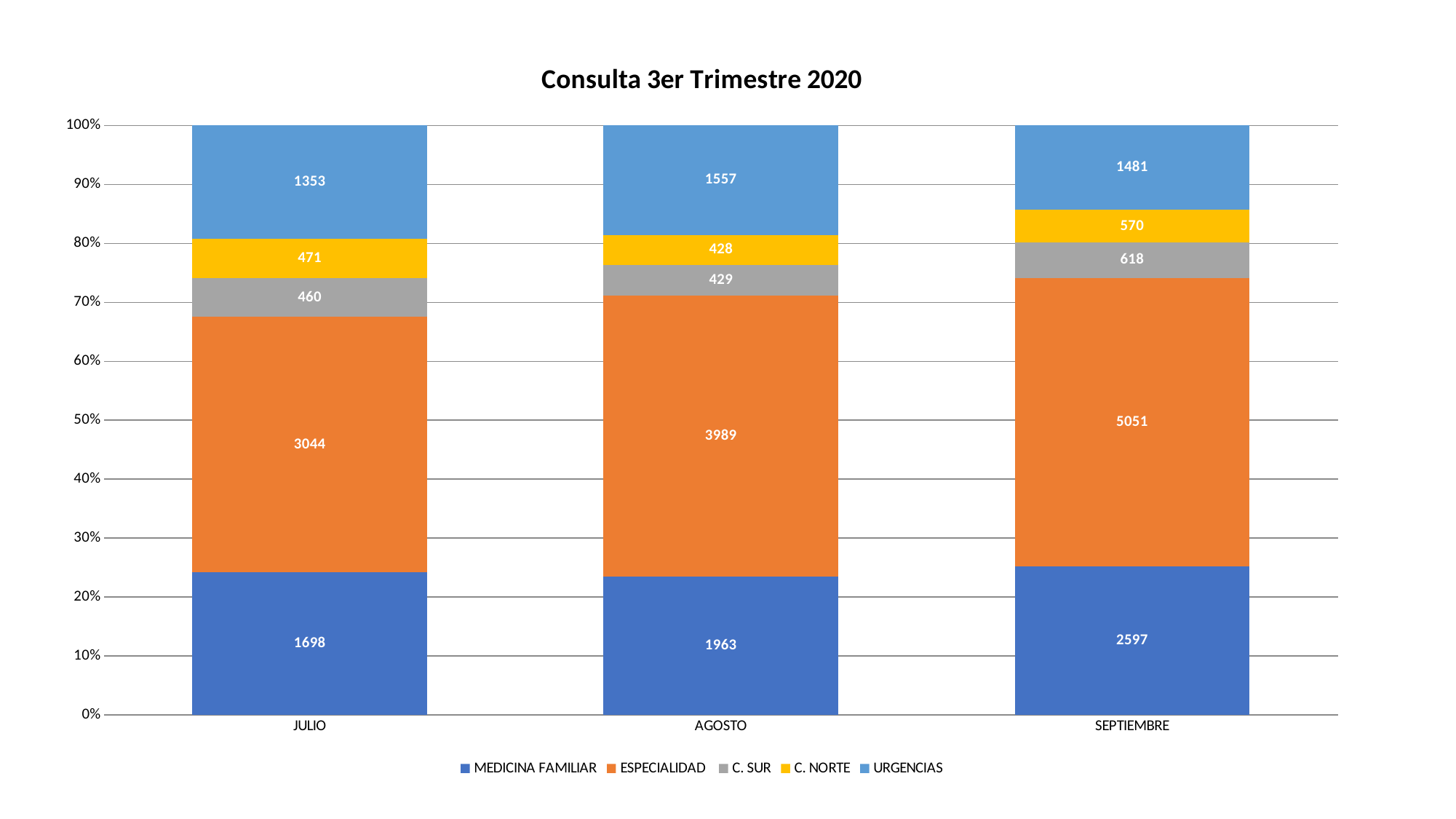
Which is larger in AGOSTO, C. SUR or C. NORTE? C. SUR What kind of chart is shown? Stacked bar chart In which month is the URGENCIAS value lowest? JULIO How many series does the legend list? 5 How many months are shown on the x axis? 3 What is the title of the chart? Consulta 3er Trimestre 2020 What is the value for ESPECIALIDAD in AGOSTO? 3989 What is the value for C. SUR in JULIO? 460 What is the value for URGENCIAS in SEPTIEMBRE? 1481 What is the difference between the ESPECIALIDAD values for SEPTIEMBRE and JULIO? 2007 What is the total of all segments in the JULIO bar? 7026 In which month is the MEDICINA FAMILIAR value highest? SEPTIEMBRE